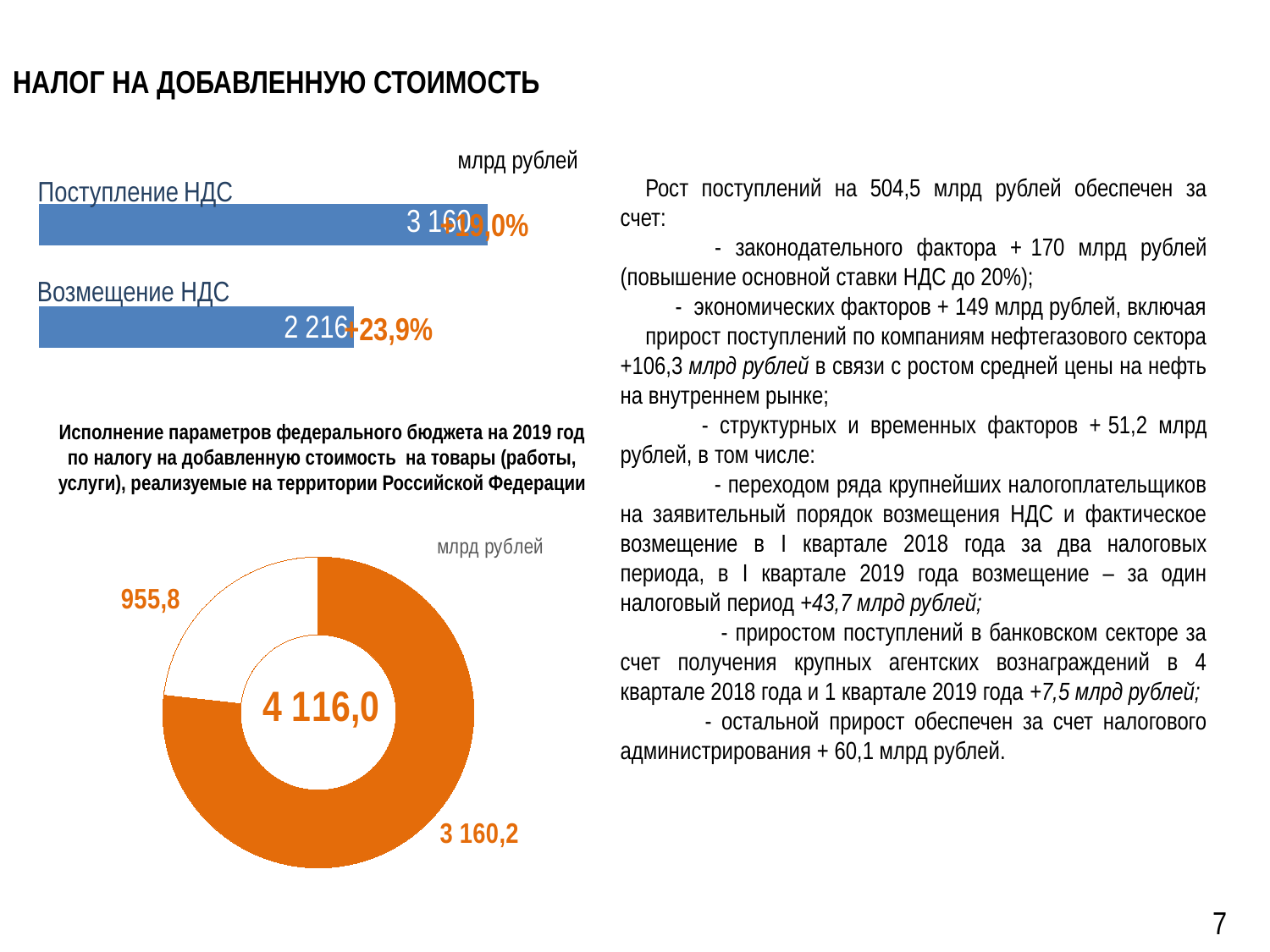
How many bars does the bar chart at the top left contain? 2 In the bar chart at the top left, which bar is longer, Поступление НДС or Возмещение НДС? Поступление НДС How many segments does the doughnut chart at the bottom left have? 2 In the doughnut chart at the bottom left, what total value is printed in the centre? 4 116,0 In the doughnut chart at the bottom left, what is the value of the smaller (white) segment? 955,8 What type of chart is shown at the top left of the slide? Bar chart In the bar chart at the top left, what growth percentage is shown next to the Возмещение НДС bar? +23,9% What type of chart is shown at the bottom left of the slide? Doughnut chart In the bar chart at the top left, what value is shown for Возмещение НДС? 2 216 In the doughnut chart at the bottom left, what is the difference between the two segment values, 3 160,2 and 955,8? 2 204,4 In what unit are the values of the doughnut chart at the bottom left expressed, according to the label above it? млрд рублей In the doughnut chart at the bottom left, what is the value of the larger (orange) segment? 3 160,2